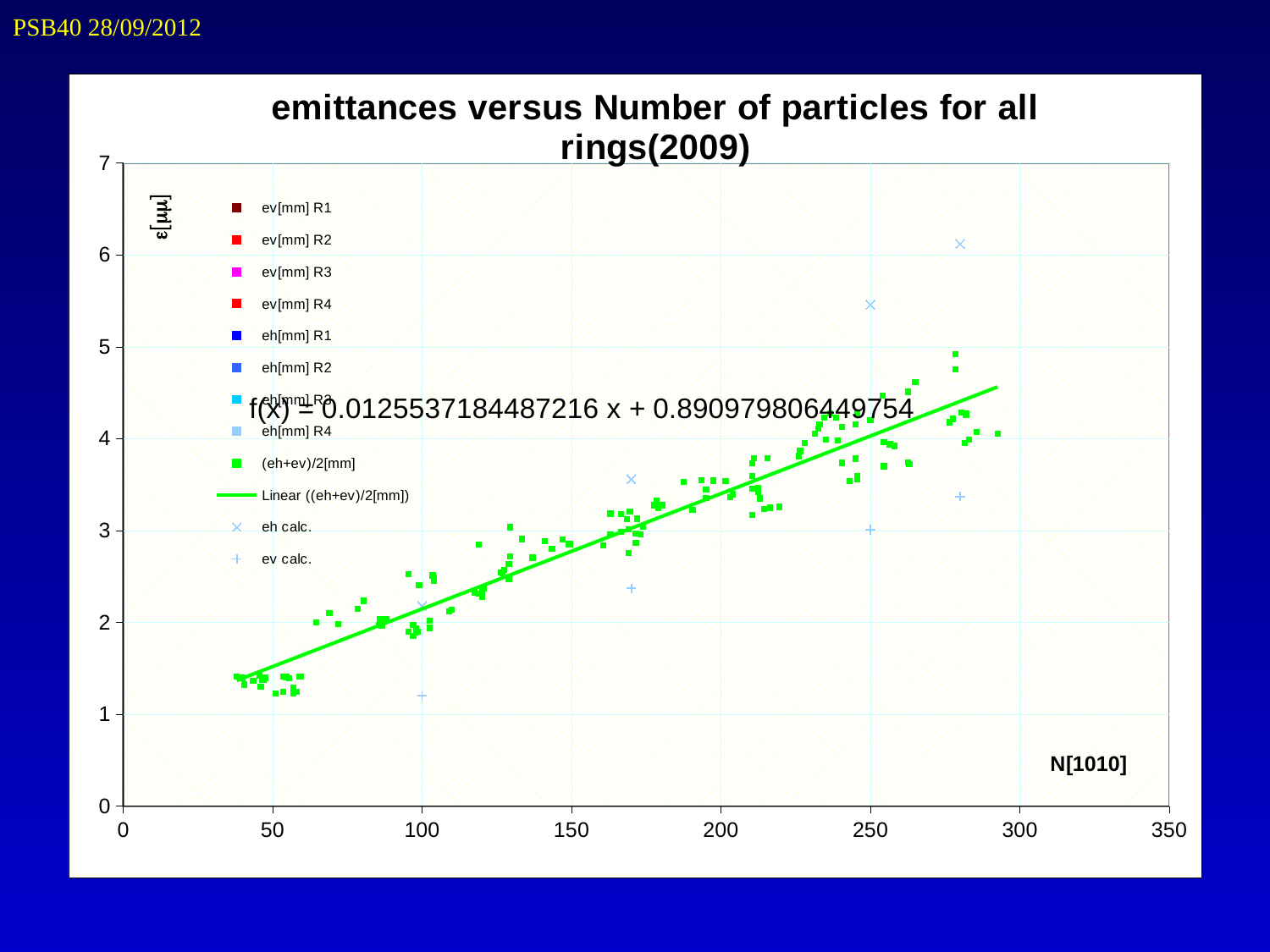
Is the ev calc. value at N = 280 greater or less than 3? greater What kind of chart is shown on the slide? scatter chart How many eh calc. points are plotted on the chart? 4 Is the ev calc. value at N = 100 greater or less than 2? less What is the intercept of the linear fit f(x) shown on the chart? 0.890979806449754 How many entries does the chart legend list? 12 Is the eh calc. value at N = 250 greater or less than 5? greater What is the title of the chart? emittances versus Number of particles for all rings(2009) Do the (eh+ev)/2[mm] values rise or fall as N increases along the x axis? rise What is the maximum value shown on the x axis? 350 What is the slope of the linear fit f(x) shown on the chart? 0.0125537184487216 Which is larger at N = 170: the eh calc. value or the ev calc. value? eh calc.